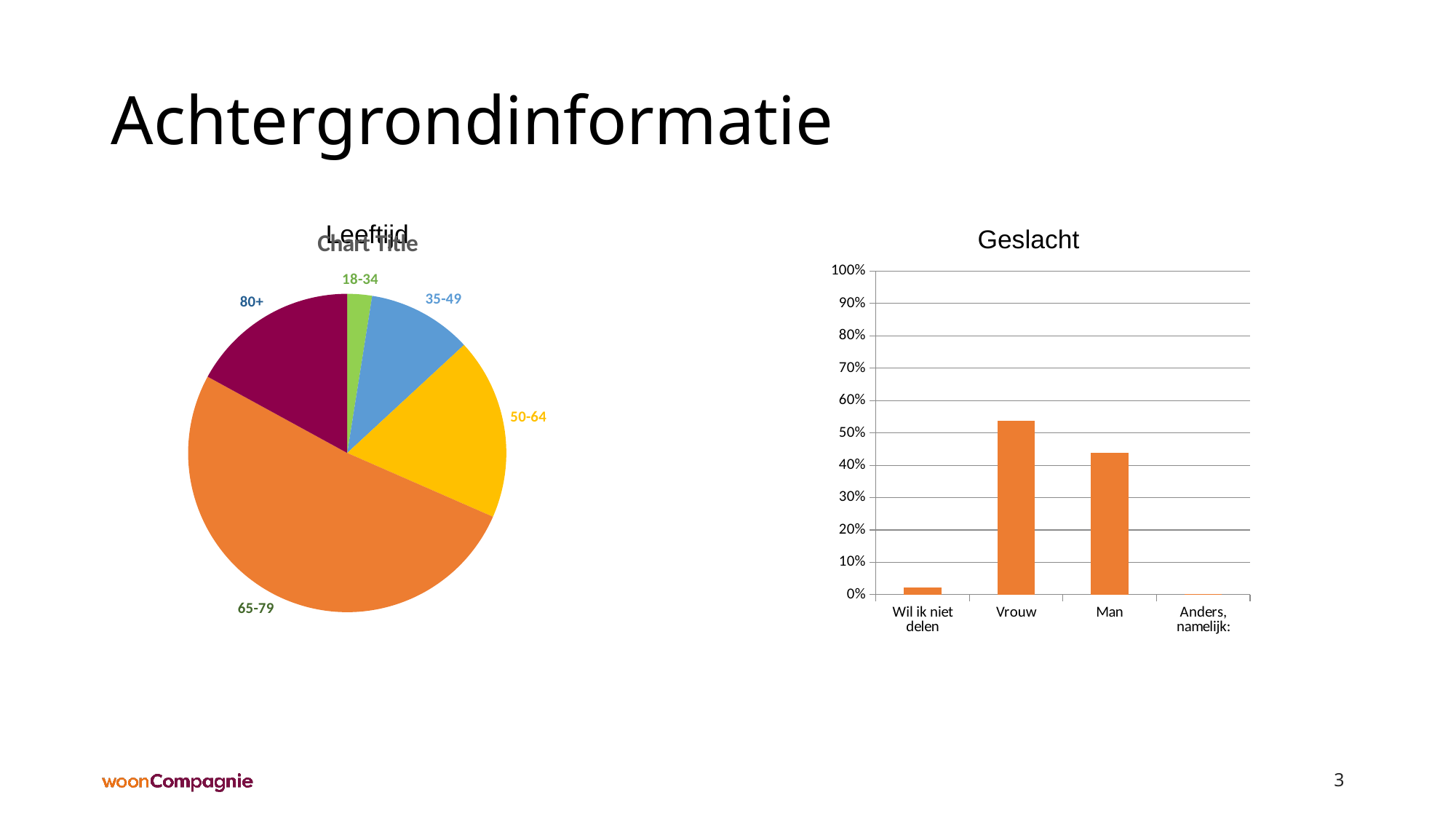
In the Geslacht chart, is the value for Vrouw greater or less than 50%? greater How many categories are shown on the x axis of the Geslacht chart? 4 Which age group has the largest slice in the Leeftijd pie chart? 65-79 In the Geslacht chart, is the value for Man greater or less than 50%? less How many slices does the Leeftijd pie chart have? 5 In the Leeftijd pie chart, which slice is larger: 80+ or 35-49? 80+ What kind of chart is the Geslacht chart on the right? bar chart In the Geslacht chart, which category has the highest bar? Vrouw What kind of chart is the Leeftijd chart on the left? pie chart In the Geslacht chart, is the value for Wil ik niet delen greater or less than 10%? less Which age group has the smallest slice in the Leeftijd pie chart? 18-34 In the Geslacht chart, which category has the lowest bar? Anders, namelijk: